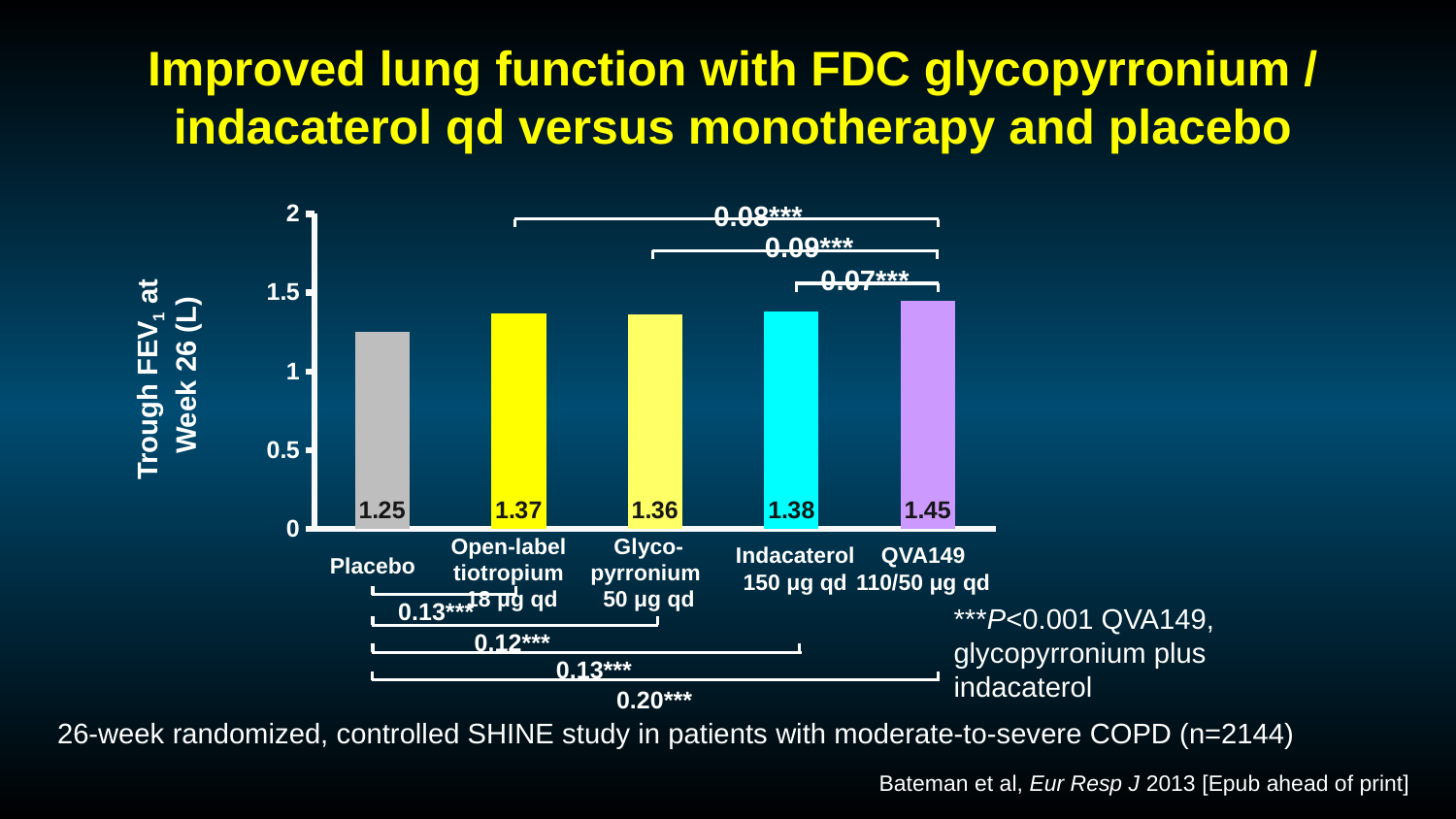
What is the difference in trough FEV1 between QVA149 and Indacaterol 150 µg qd? 0.07 Which treatment group has the lowest trough FEV1 at Week 26? Placebo What is the difference in trough FEV1 between QVA149 and Placebo? 0.20 What is the trough FEV1 at Week 26 for Indacaterol 150 µg qd? 1.38 Which treatment group has the highest trough FEV1 at Week 26? QVA149 110/50 µg qd What kind of chart is shown on the slide? bar chart What is the trough FEV1 at Week 26 for Glycopyrronium 50 µg qd? 1.36 Is the trough FEV1 value for QVA149 greater or less than 1.5? less How many treatment groups are shown in the chart? 5 What is the trough FEV1 at Week 26 for Placebo? 1.25 Which has a larger trough FEV1 at Week 26, Placebo or Indacaterol 150 µg qd? Indacaterol 150 µg qd What is the trough FEV1 at Week 26 for QVA149 110/50 µg qd? 1.45